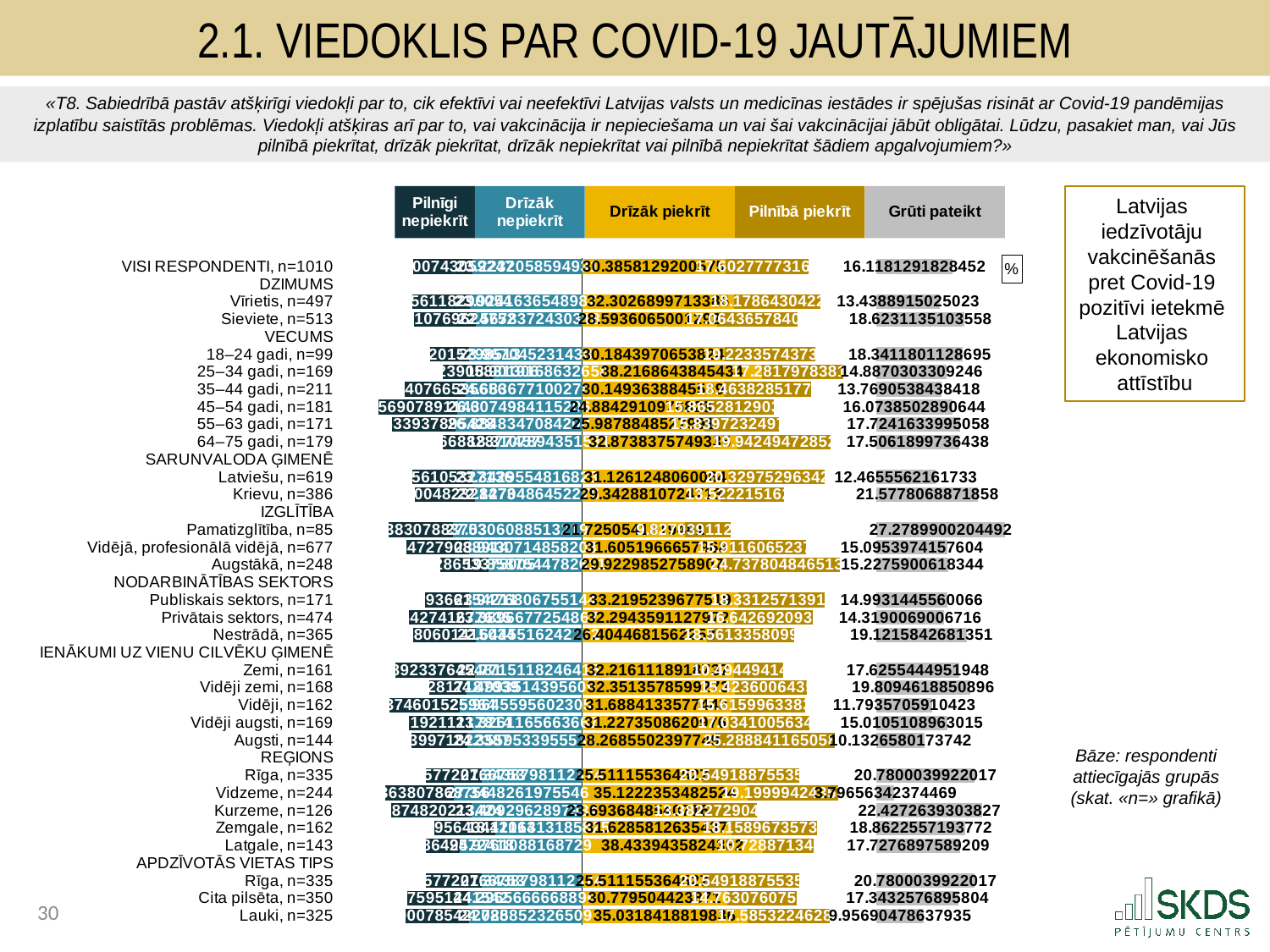
Which has the larger 'Grūti pateikt' value: Pamatizglītība, n=85 or Vidēji, n=162? Pamatizglītība, n=85 Which group has the highest 'Grūti pateikt' value? Pamatizglītība, n=85 How many respondent groups (bars) are plotted in the chart? 30 What is the last series listed in the chart legend? Grūti pateikt What is the first series listed in the chart legend? Pilnīgi nepiekrīt Which has the larger 'Grūti pateikt' value: Sieviete, n=513 or Vīrietis, n=497? Sieviete, n=513 What is the 'Grūti pateikt' value for Kurzeme, n=126? 22.4272639303827 What is the 'Grūti pateikt' value for VISI RESPONDENTI, n=1010? 16.1181291828452 How many series does the legend of the chart list? 5 What is the 'Grūti pateikt' value for Pamatizglītība, n=85? 27.2789900204492 What kind of chart is shown on the slide? bar chart What is the 'Grūti pateikt' value for Vidēji, n=162? 11.7935705910423